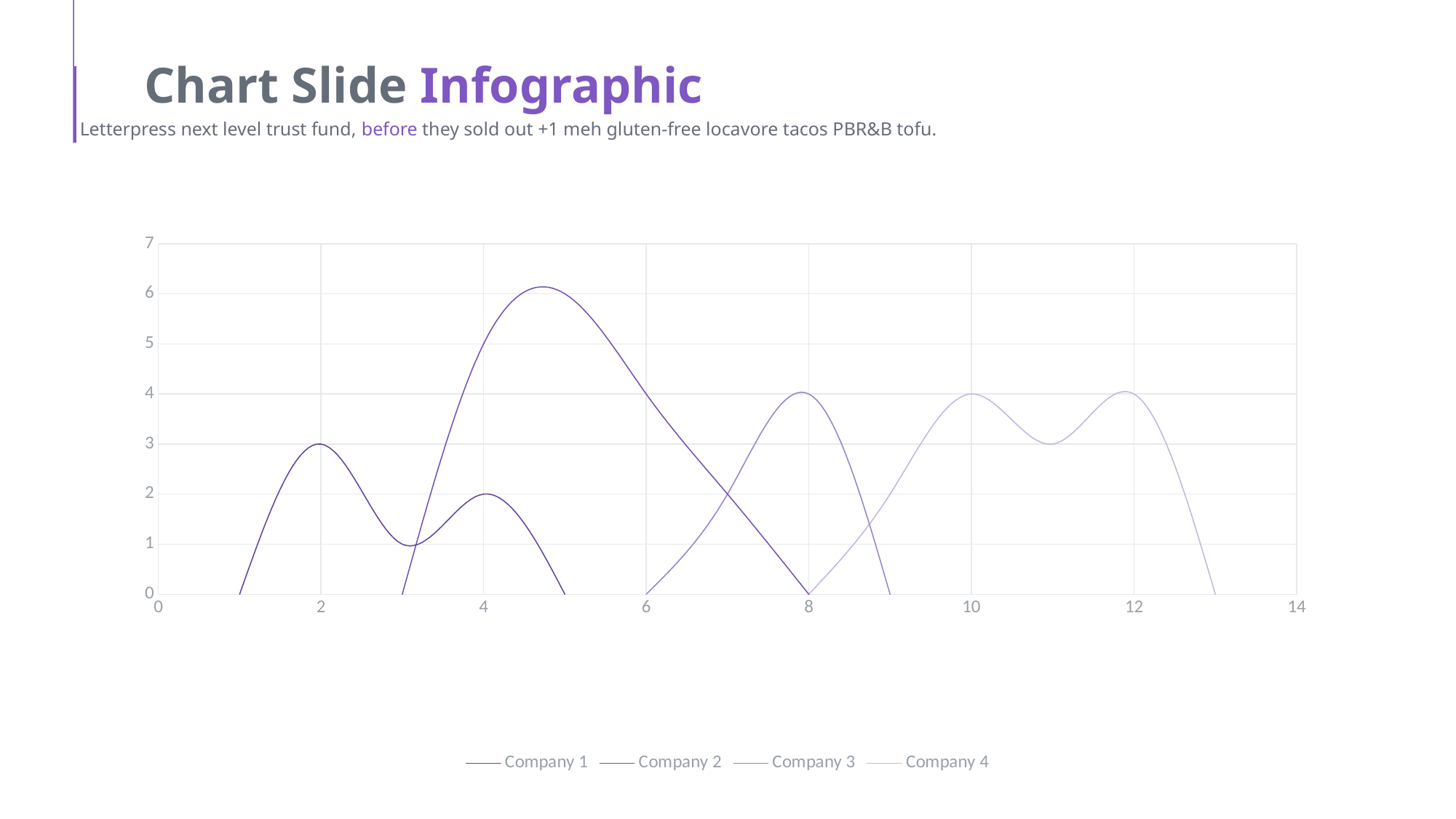
How many series does the legend list? 4 What kind of chart is shown on the slide? line chart Which reaches a higher peak, Company 2 or Company 3? Company 2 What are the legend entries of the chart? Company 1, Company 2, Company 3, Company 4 What is the highest value shown on the vertical axis? 7 Is the highest value reached by Company 1 greater or less than 4? less What is the value of Company 1 at x = 2? 3 Is the value of Company 4 at x = 11 greater or less than 4? less Is the peak value of Company 2 greater or less than 5? greater Which reaches a higher peak, Company 1 or Company 4? Company 4 What is the value of Company 3 at x = 8? 4 Which series reaches the highest value on the chart? Company 2